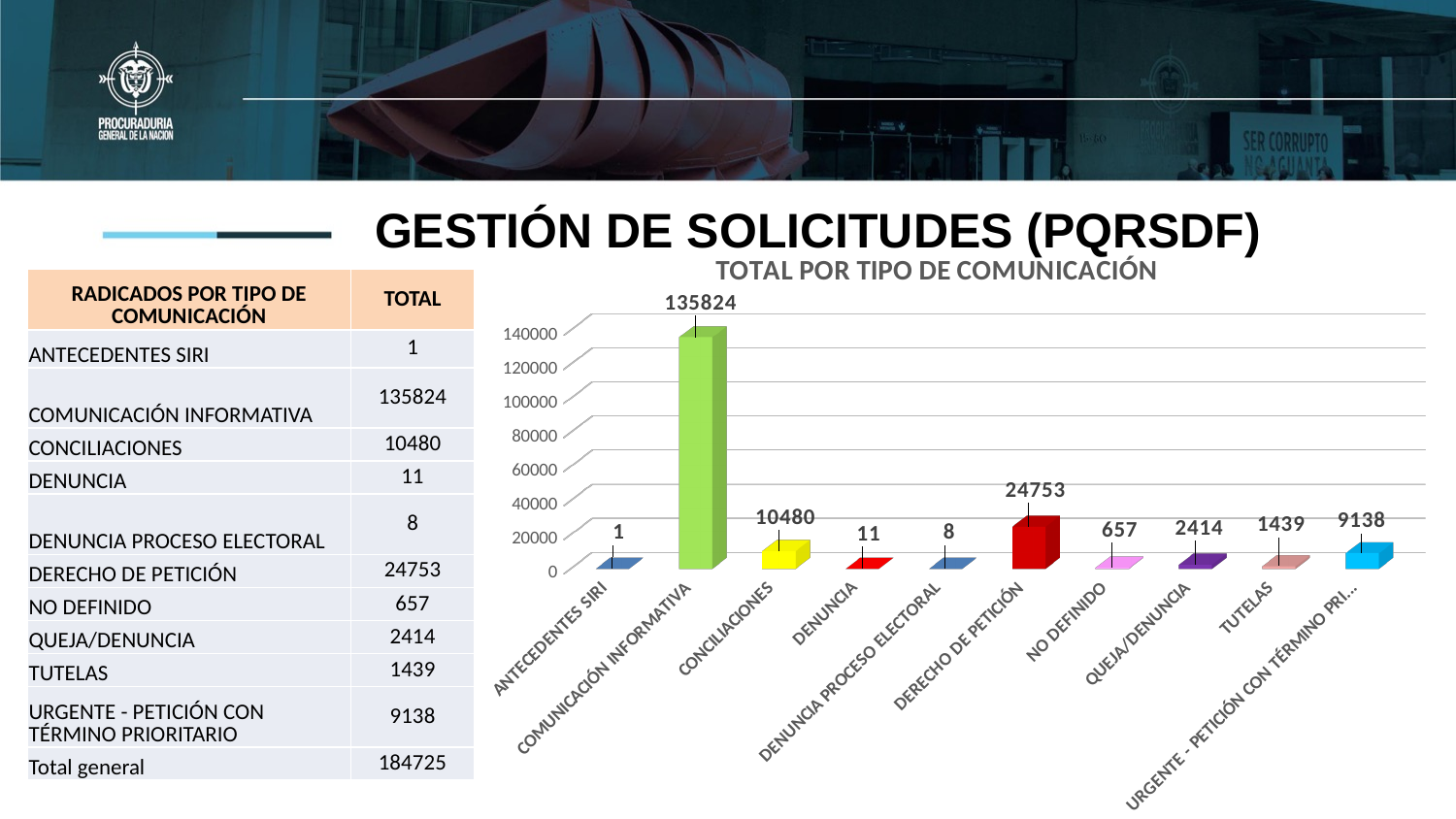
How many categories are shown on the x axis of the chart? 10 Which is larger, the value for CONCILIACIONES or the value for URGENTE - PETICIÓN CON TÉRMINO PRIORITARIO? CONCILIACIONES What is the value for QUEJA/DENUNCIA in the chart? 2414 What is the value for TUTELAS in the chart? 1439 Is the value for DERECHO DE PETICIÓN greater or less than 20000? greater What is the value for COMUNICACIÓN INFORMATIVA in the chart? 135824 What is the difference between the values for DERECHO DE PETICIÓN and CONCILIACIONES? 14273 What is the title of the chart? TOTAL POR TIPO DE COMUNICACIÓN Which category has the highest value in the chart? COMUNICACIÓN INFORMATIVA What type of chart is shown under the title 'TOTAL POR TIPO DE COMUNICACIÓN'? Bar chart Which category has the lowest value in the chart? ANTECEDENTES SIRI What is the value for DERECHO DE PETICIÓN in the chart? 24753